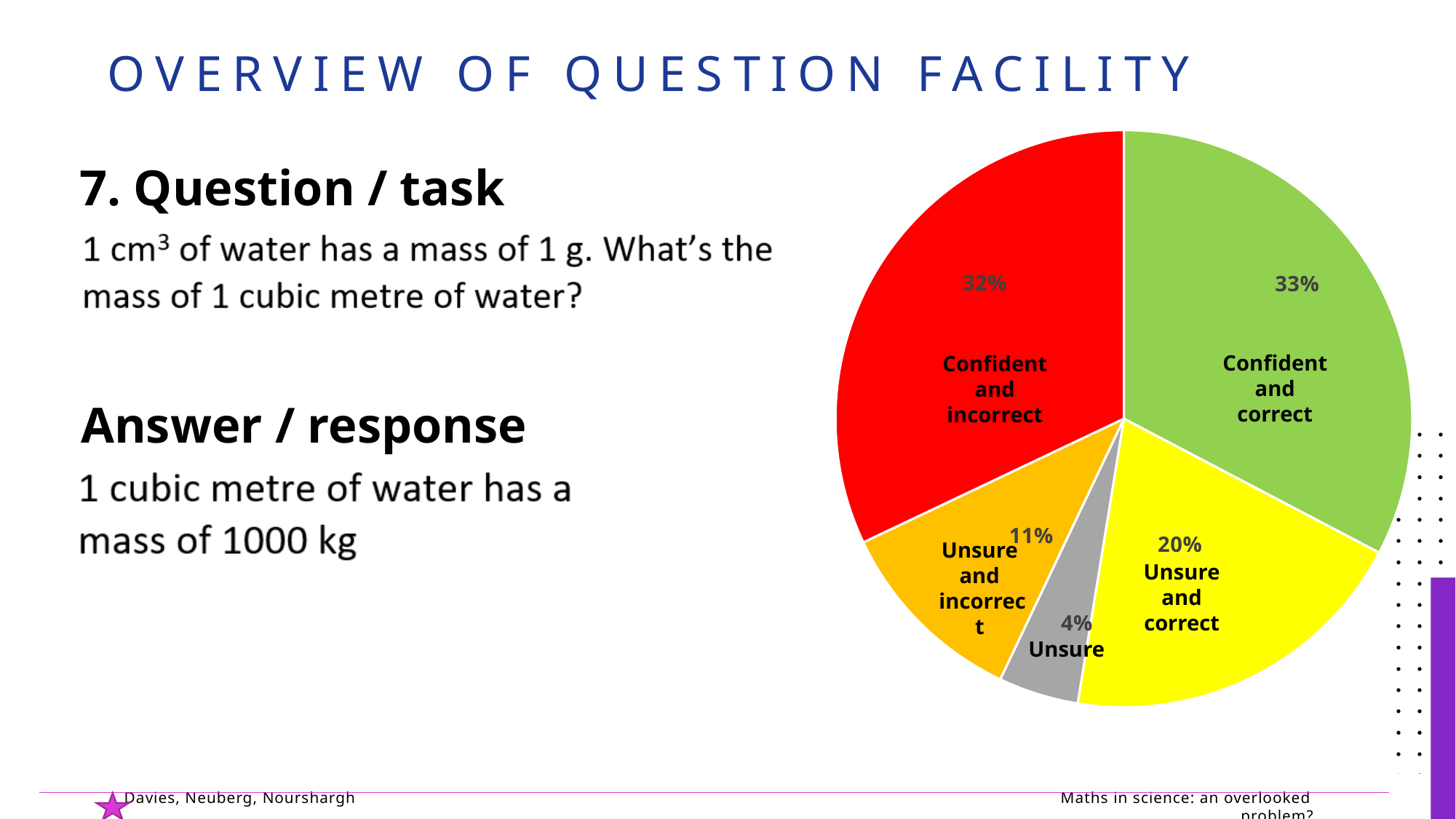
Which is larger, "Unsure and correct" or "Unsure and incorrect"? Unsure and correct Which category has the largest slice of the pie? Confident and correct How many slices does the pie chart have? 5 What percentage of responses were "Unsure"? 4% What percentage of responses were "Confident and correct"? 33% What colour is the "Confident and incorrect" slice? red What kind of chart is shown on the slide? pie chart What percentage of responses were "Confident and incorrect"? 32% What is the difference between the "Unsure and correct" and "Unsure and incorrect" percentages? 9% What percentage of responses were "Unsure and incorrect"? 11% Which category has the smallest slice of the pie? Unsure What percentage of responses were "Unsure and correct"? 20%